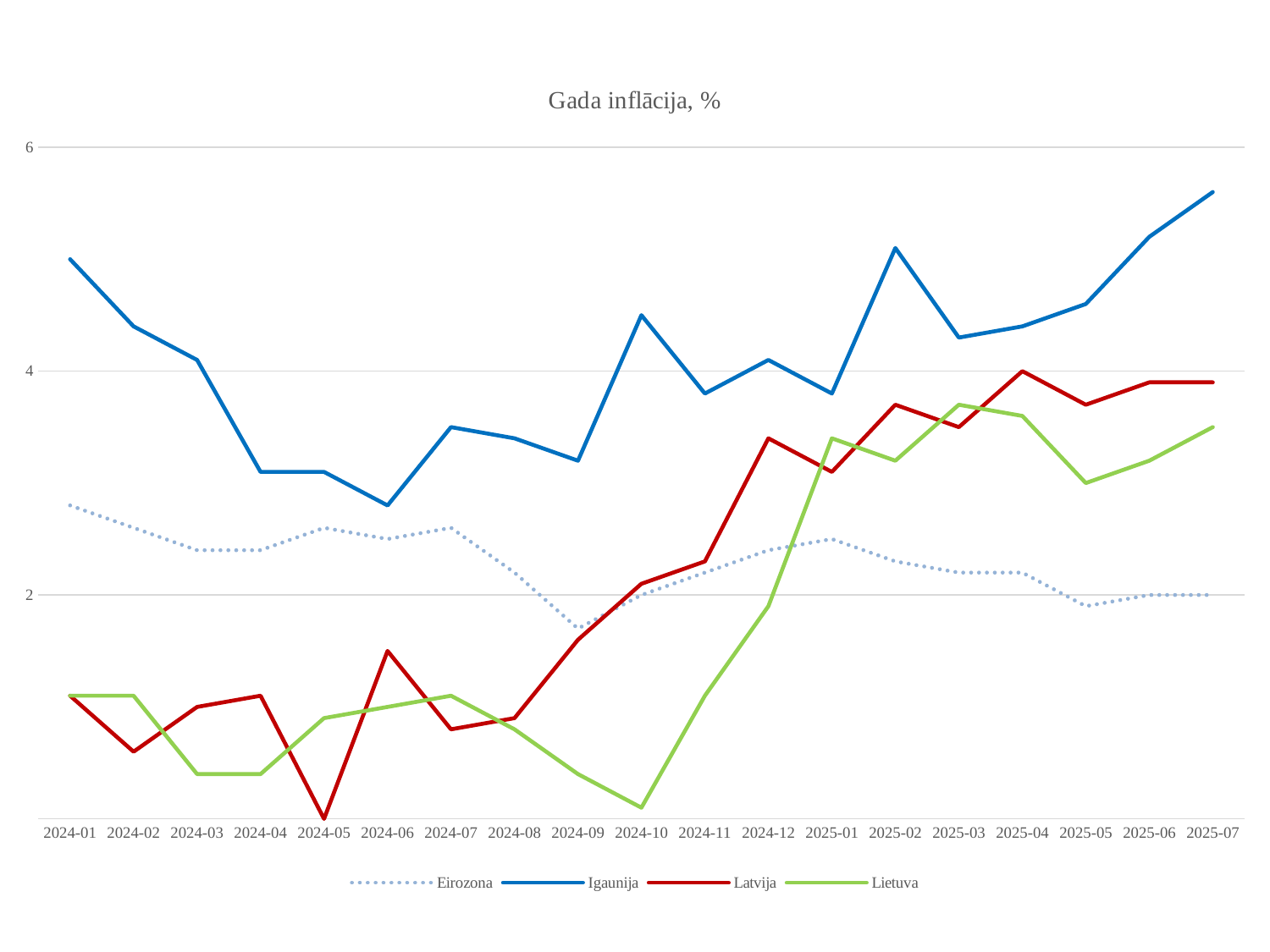
How many series does the legend list? 4 What kind of chart is shown on the slide? Line chart In which month does the Latvija series reach its lowest value? 2024-05 Which series has the highest value in 2025-07? Igaunija How many months are plotted along the x axis? 19 Is the value for Igaunija in 2024-01 greater or less than 4? greater What is the title of the chart? Gada inflācija, % Which series is drawn with a dotted line? Eirozona In which month does the Igaunija series reach its lowest value? 2024-06 Does the Lietuva series rise or fall from 2024-10 to 2025-01? Rises In which month does the Igaunija series reach its highest value? 2025-07 Is the value for Latvija in 2024-12 greater or less than 4? less